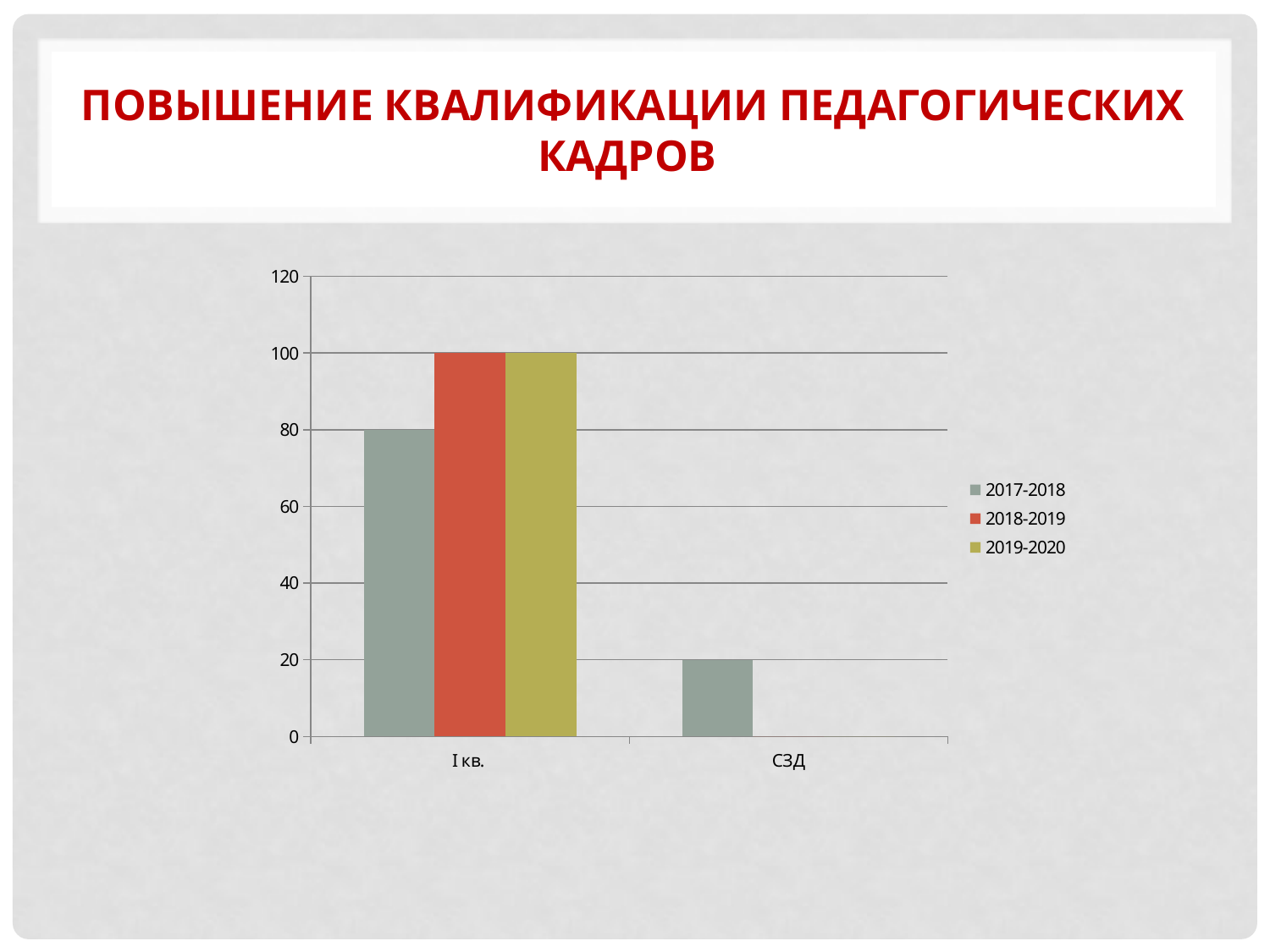
What is the difference between the 2018-2019 and 2017-2018 values in the I кв. category? 20 How many categories are shown on the x axis? 2 What kind of chart is shown on the slide? bar chart Which is larger in the I кв. category: the 2017-2018 value or the 2019-2020 value? 2019-2020 What is the value for 2017-2018 in the СЗД category? 20 What is the value for 2018-2019 in the I кв. category? 100 What is the value for 2019-2020 in the I кв. category? 100 What is the difference between the 2017-2018 values for I кв. and СЗД? 60 Which category has the lowest value for the 2017-2018 series? СЗД What is the title of the slide? ПОВЫШЕНИЕ КВАЛИФИКАЦИИ ПЕДАГОГИЧЕСКИХ КАДРОВ What is the value for 2017-2018 in the I кв. category? 80 How many series does the legend list? 3